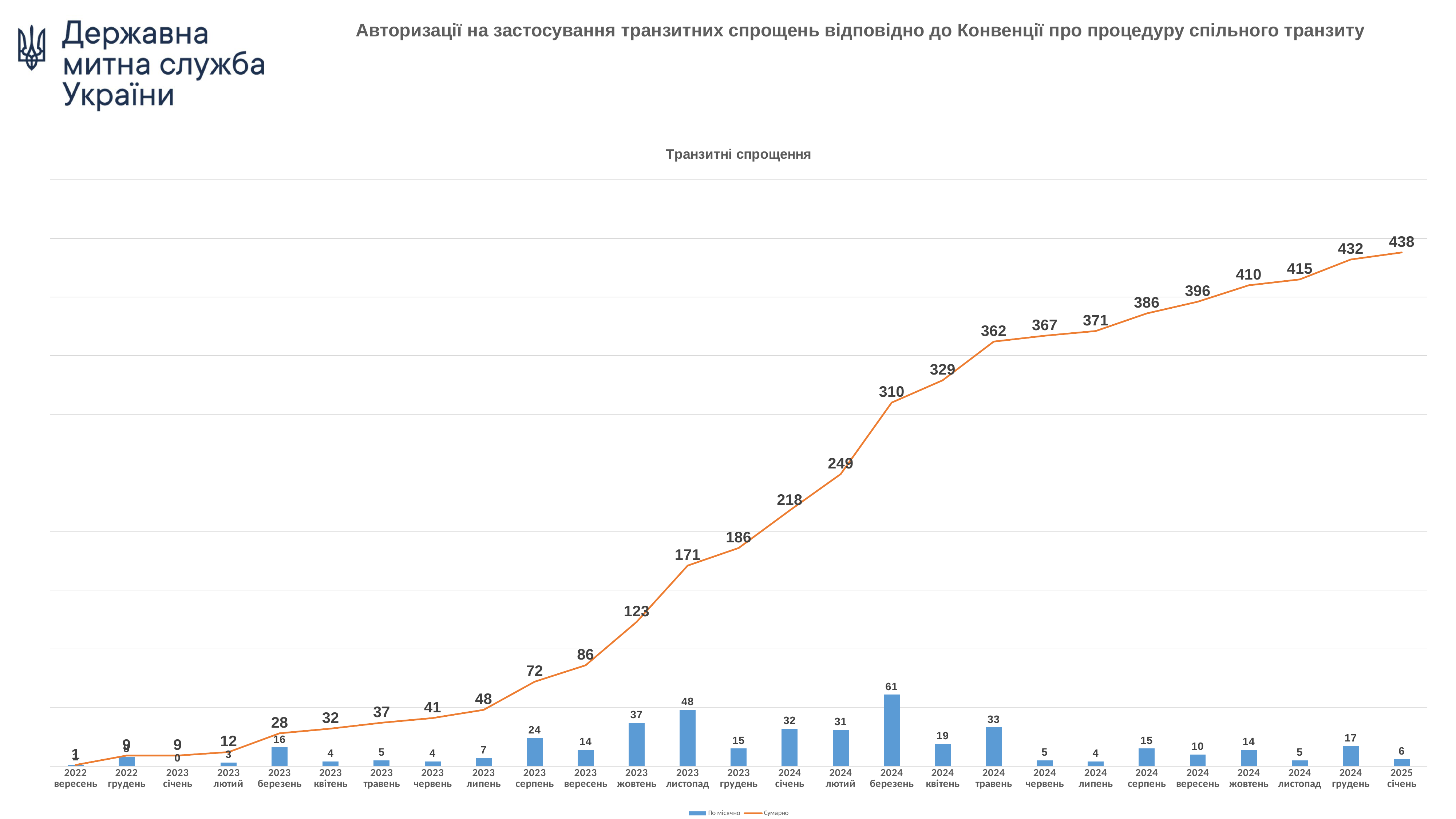
What is the difference between the cumulative values for 2024 березень and 2024 лютий? 61 What is the cumulative value (Сумарно) for 2025 січень? 438 How many months (categories) are shown on the x axis? 27 What kind of chart is this? Combined bar and line chart What is the monthly value (По місячно) for 2023 жовтень? 37 Does the cumulative line (Сумарно) rise or fall along the x axis? Rises What is the monthly value (По місячно) for 2024 березень? 61 How many series does the legend list? 2 What is the cumulative value (Сумарно) for 2023 листопад? 171 Which is larger, the monthly value for 2023 серпень or for 2024 квітень? 2023 серпень Which month has the lowest monthly value (По місячно)? 2023 січень Which month has the highest monthly value (По місячно)? 2024 березень